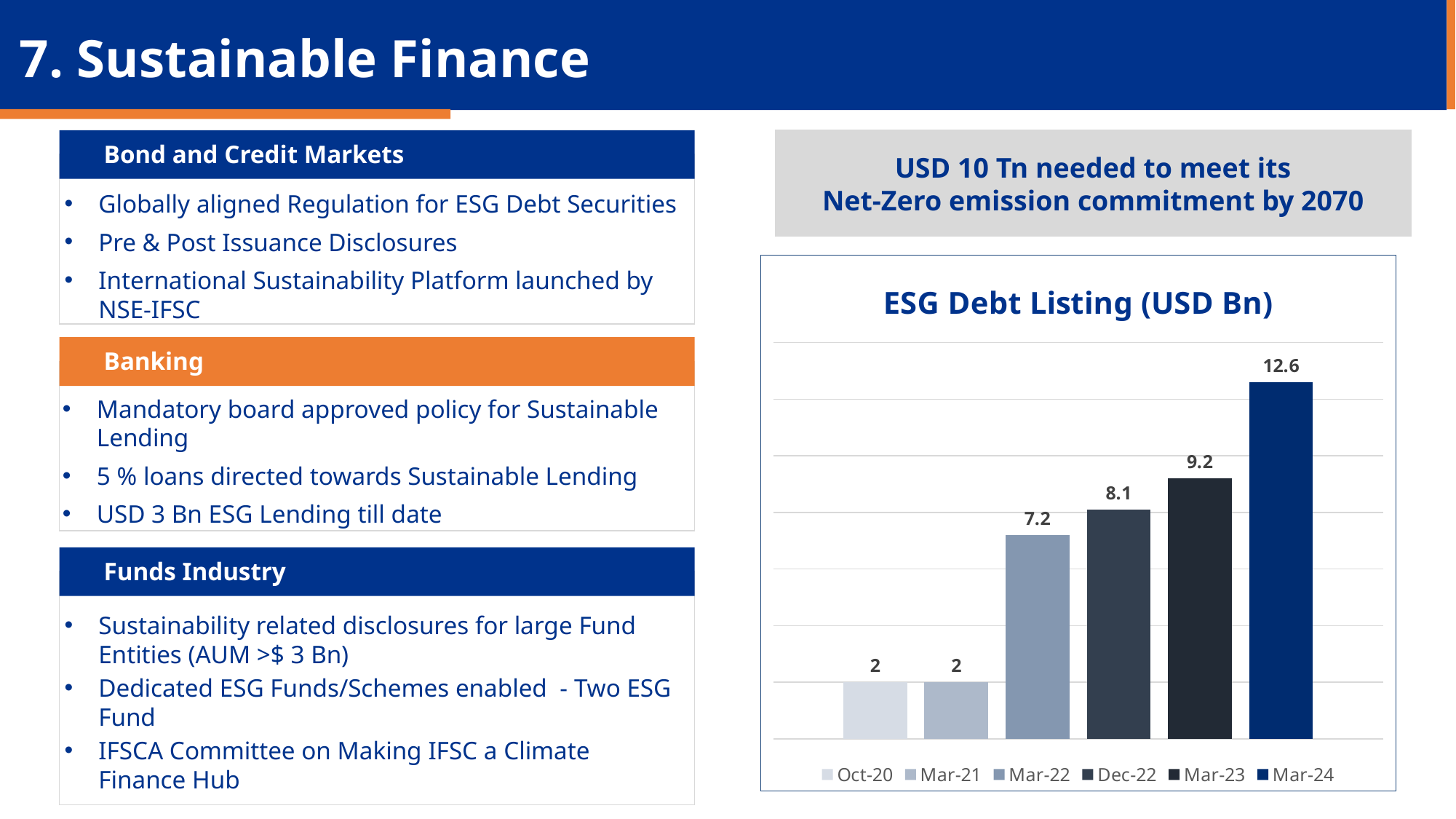
What kind of chart is the ESG Debt Listing chart? Bar chart What is the difference between the ESG debt listing values for Mar-24 and Mar-23? 3.4 What is the ESG debt listing value for Mar-24? 12.6 What is the ESG debt listing value for Dec-22? 8.1 Do the ESG debt listing values rise or fall from Oct-20 to Mar-24? Rise How many entries does the legend of the ESG Debt Listing chart list? 6 Which is larger, the ESG debt listing value for Dec-22 or for Mar-23? Mar-23 What is the ESG debt listing value for Oct-20? 2 Which period has the highest ESG debt listing value? Mar-24 What is the ESG debt listing value for Mar-22? 7.2 What is the difference between the ESG debt listing values for Mar-22 and Mar-21? 5.2 How many periods are shown in the ESG Debt Listing chart? 6